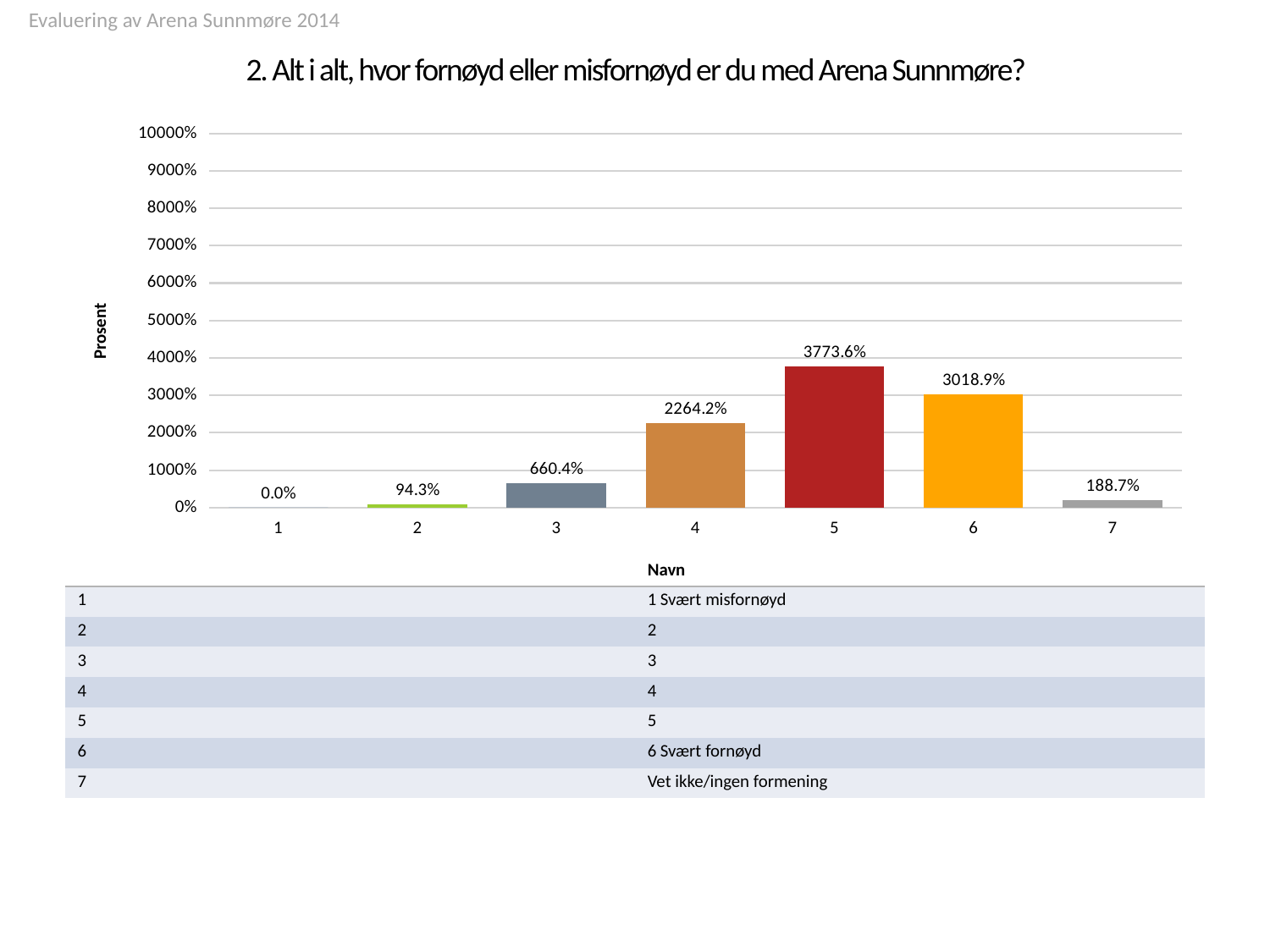
What is the value for category 3? 660.4% Which is larger, the value for category 4 or the value for category 6? 6 Is the value for category 5 greater or less than 3000%? greater What kind of chart is shown on the slide? bar chart How many categories are shown on the x axis? 7 What is the difference between the values for category 5 and category 6? 754.7% What is the difference between the values for category 4 and category 3? 1603.8% What is the value for category 5? 3773.6% Which category has the highest value? 5 What is the value for category 7? 188.7% What is the label of the y axis? Prosent Which category has the lowest value? 1